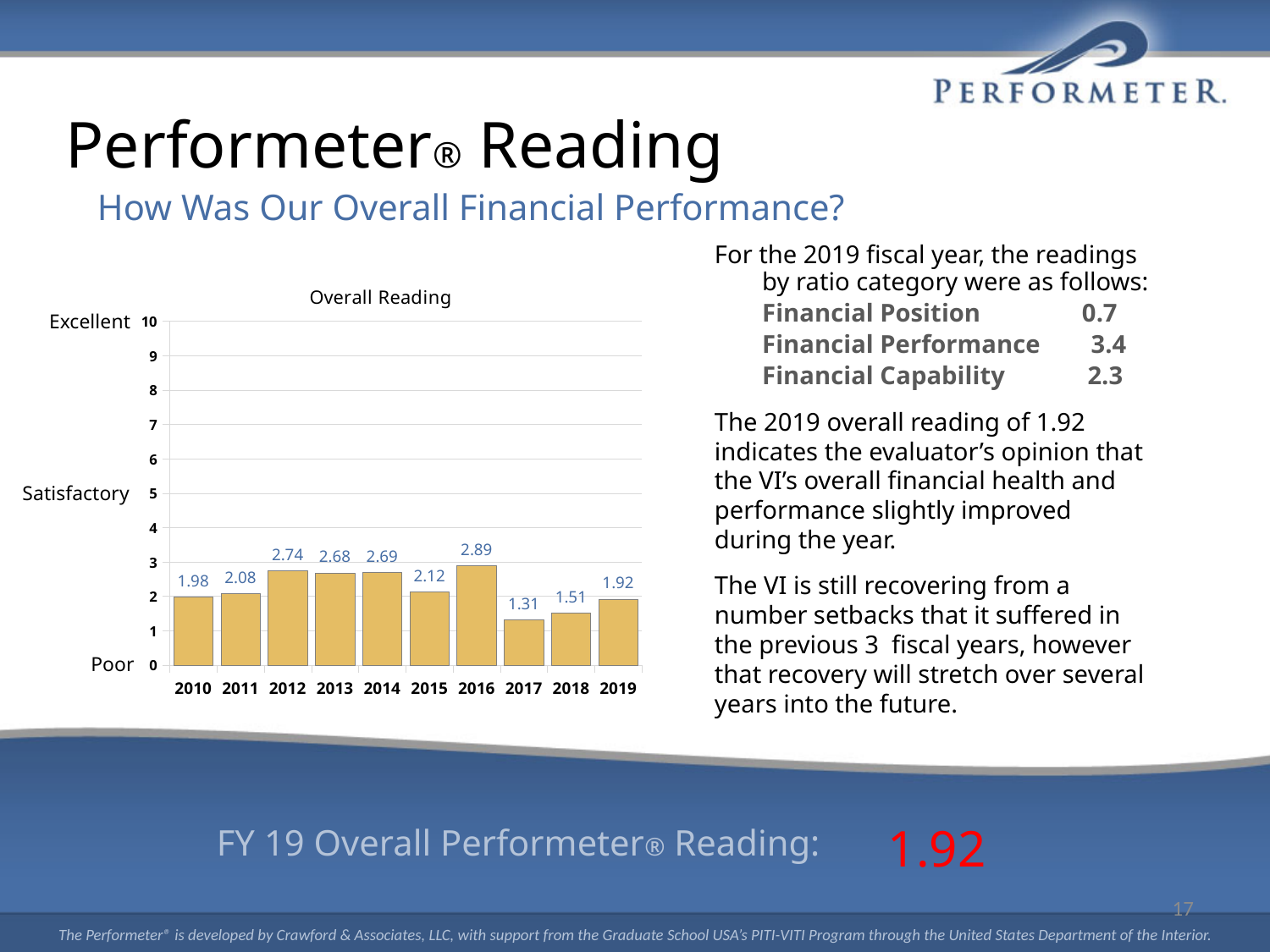
What is the title of the chart on the slide? Overall Reading Which year has the highest Overall Reading? 2016 What is the Overall Reading value for 2016? 2.89 Did the Overall Reading rise or fall from 2017 to 2019? rise How many years are shown on the x axis of the Overall Reading chart? 10 Which year has a larger Overall Reading, 2012 or 2015? 2012 Is the Overall Reading for 2019 greater or less than 5? less What is the difference between the Overall Reading for 2016 and 2017? 1.58 What is the Overall Reading value for 2010? 1.98 What is the Overall Reading value for 2017? 1.31 Which year has the lowest Overall Reading? 2017 What kind of chart is the Overall Reading chart? bar chart